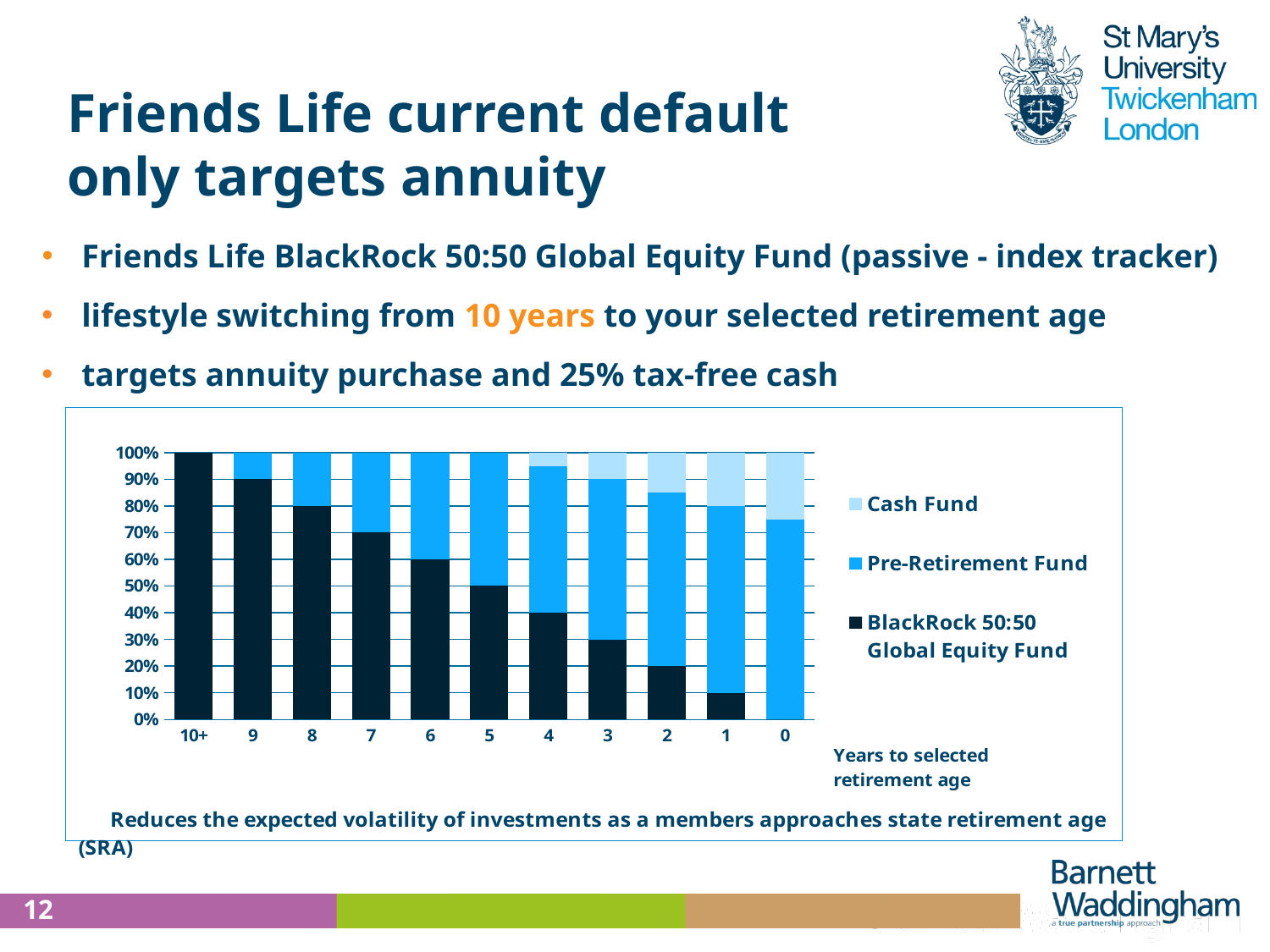
Does the BlackRock 50:50 Global Equity Fund allocation rise or fall moving from 10+ years to 0 years along the x axis? Fall What is the allocation to the BlackRock 50:50 Global Equity Fund at 10+ years to selected retirement age? 100% What is the difference between the BlackRock 50:50 Global Equity Fund allocation at 9 years and at 6 years to selected retirement age? 30% What kind of chart is shown on the slide? Stacked bar chart How many categories are shown along the x axis of the chart? 11 What is the allocation to the BlackRock 50:50 Global Equity Fund at 5 years to selected retirement age? 50% What is the allocation to the BlackRock 50:50 Global Equity Fund at 1 year to selected retirement age? 10% How many series does the chart legend list? 3 What is the allocation to the Pre-Retirement Fund at 8 years to selected retirement age? 20% Is the BlackRock 50:50 Global Equity Fund allocation larger at 8 years or at 3 years to selected retirement age? 8 years Is the Pre-Retirement Fund allocation at 0 years to selected retirement age greater or less than 50%? greater At which number of years to selected retirement age is the BlackRock 50:50 Global Equity Fund allocation highest? 10+